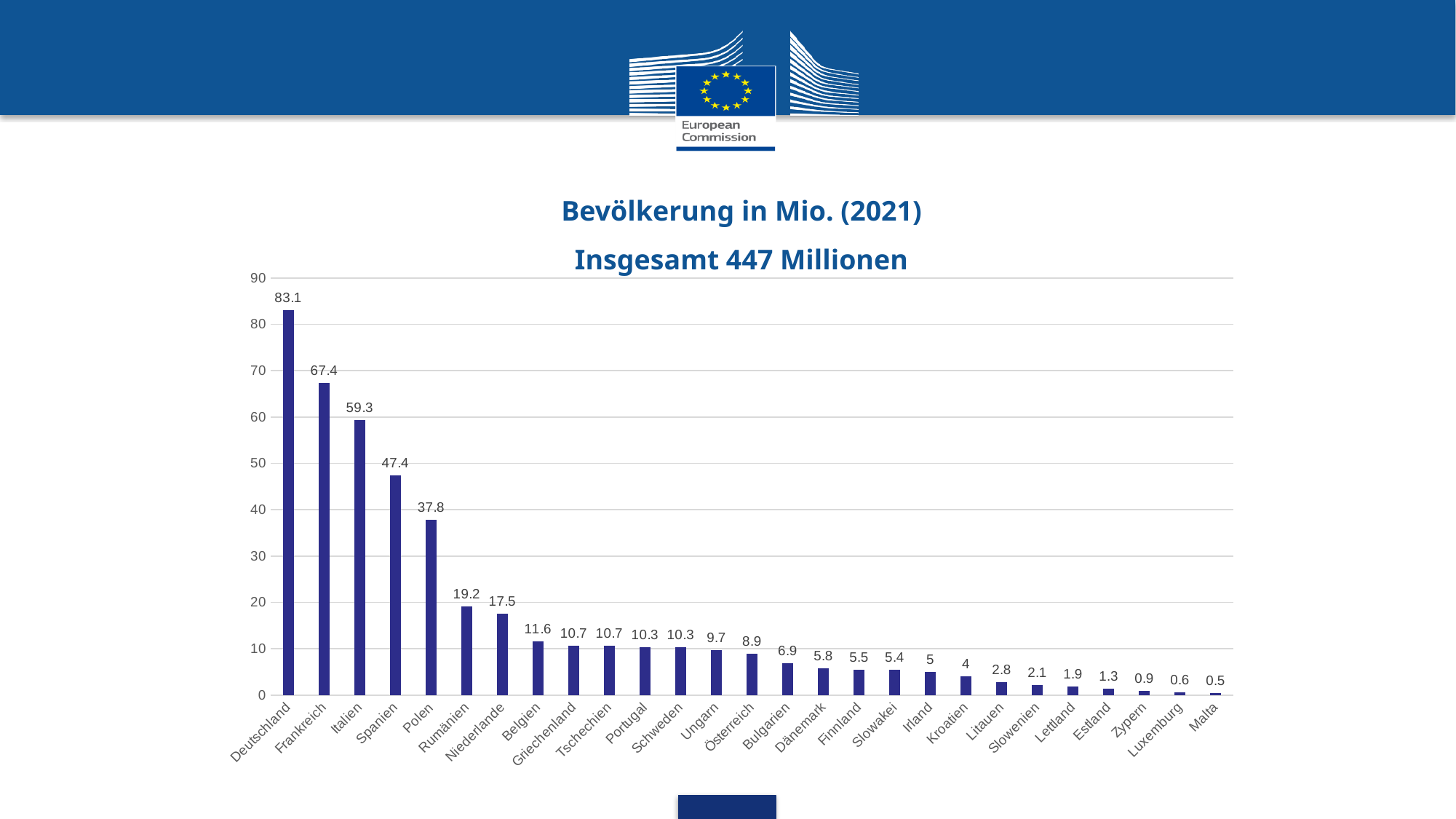
What is the value shown for Polen? 37.8 What is the value shown for Österreich? 8.9 What is the difference between the values for Frankreich and Italien? 8.1 Which country has the lowest bar in the chart? Malta Is the value for Rumänien greater or less than 20? less How many countries are shown in the chart? 27 Which has a larger value, Spanien or Polen? Spanien What total population is stated in the chart title? 447 Millionen Which country has the highest bar in the chart? Deutschland What kind of chart is shown on the slide? bar chart What is the population value shown for Deutschland? 83.1 Do the values rise or fall from left to right along the x axis? fall